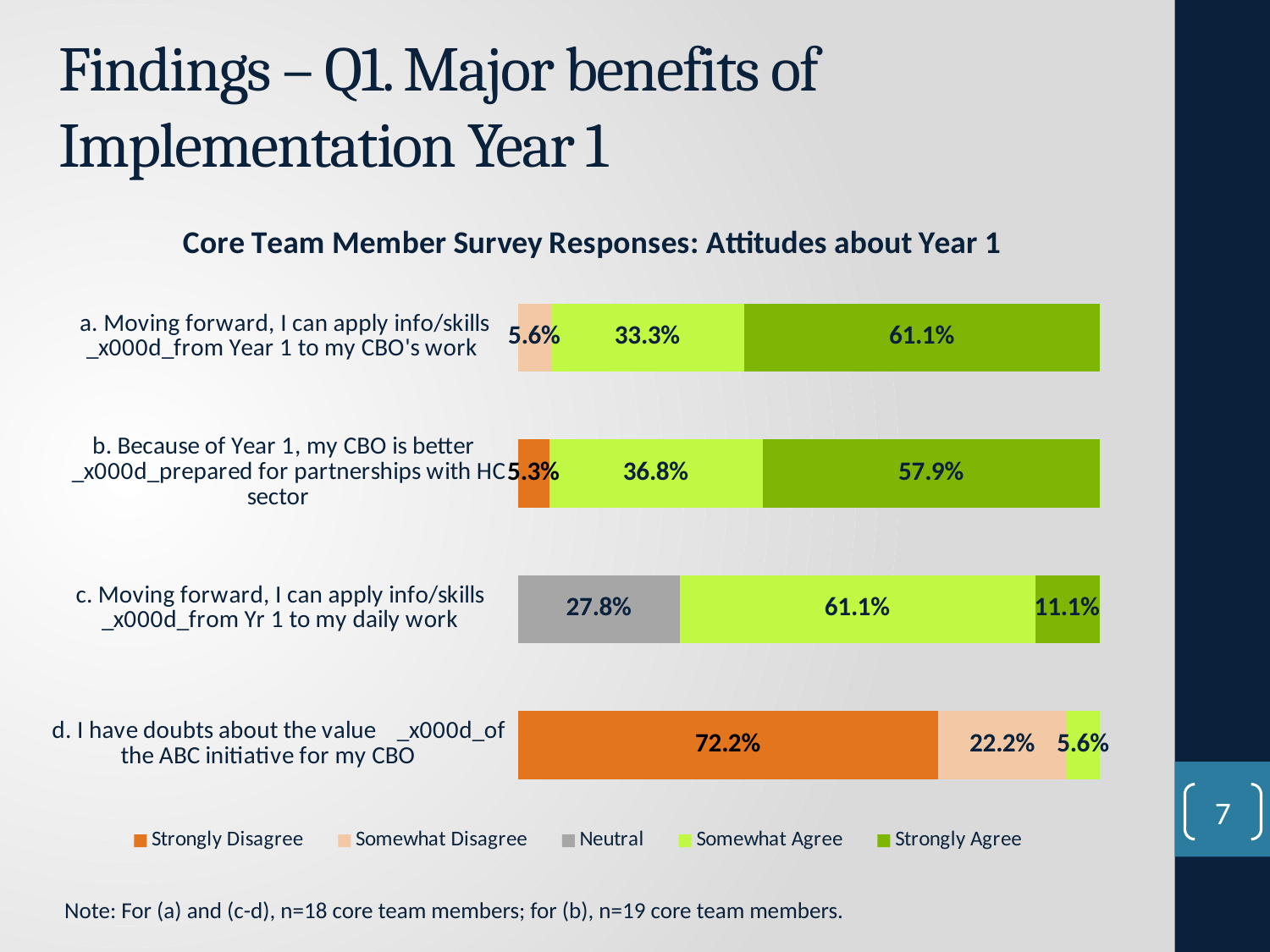
Which statement has the lowest Strongly Agree percentage among those with a Strongly Agree segment? c. Moving forward, I can apply info/skills from Yr 1 to my daily work Which statement has the highest Strongly Agree percentage? a. Moving forward, I can apply info/skills from Year 1 to my CBO's work How many series does the legend list? 5 What percentage of respondents strongly disagreed with statement (d), 'I have doubts about the value of the ABC initiative for my CBO'? 72.2% What is the title of the chart? Core Team Member Survey Responses: Attitudes about Year 1 What percentage of respondents somewhat agreed with statement (b), 'Because of Year 1, my CBO is better prepared for partnerships with HC sector'? 36.8% What percentage of respondents were neutral on statement (c), 'Moving forward, I can apply info/skills from Yr 1 to my daily work'? 27.8% How many statements (categories) are plotted in the chart? 4 What is the difference between the Strongly Agree percentages for statement (a) and statement (b)? 3.2% What percentage of respondents strongly agreed with statement (a), 'Moving forward, I can apply info/skills from Year 1 to my CBO's work'? 61.1% Which is larger: the Somewhat Agree percentage for statement (c) or the Strongly Disagree percentage for statement (d)? Strongly Disagree for statement (d) What type of chart is shown on the slide? Stacked bar chart